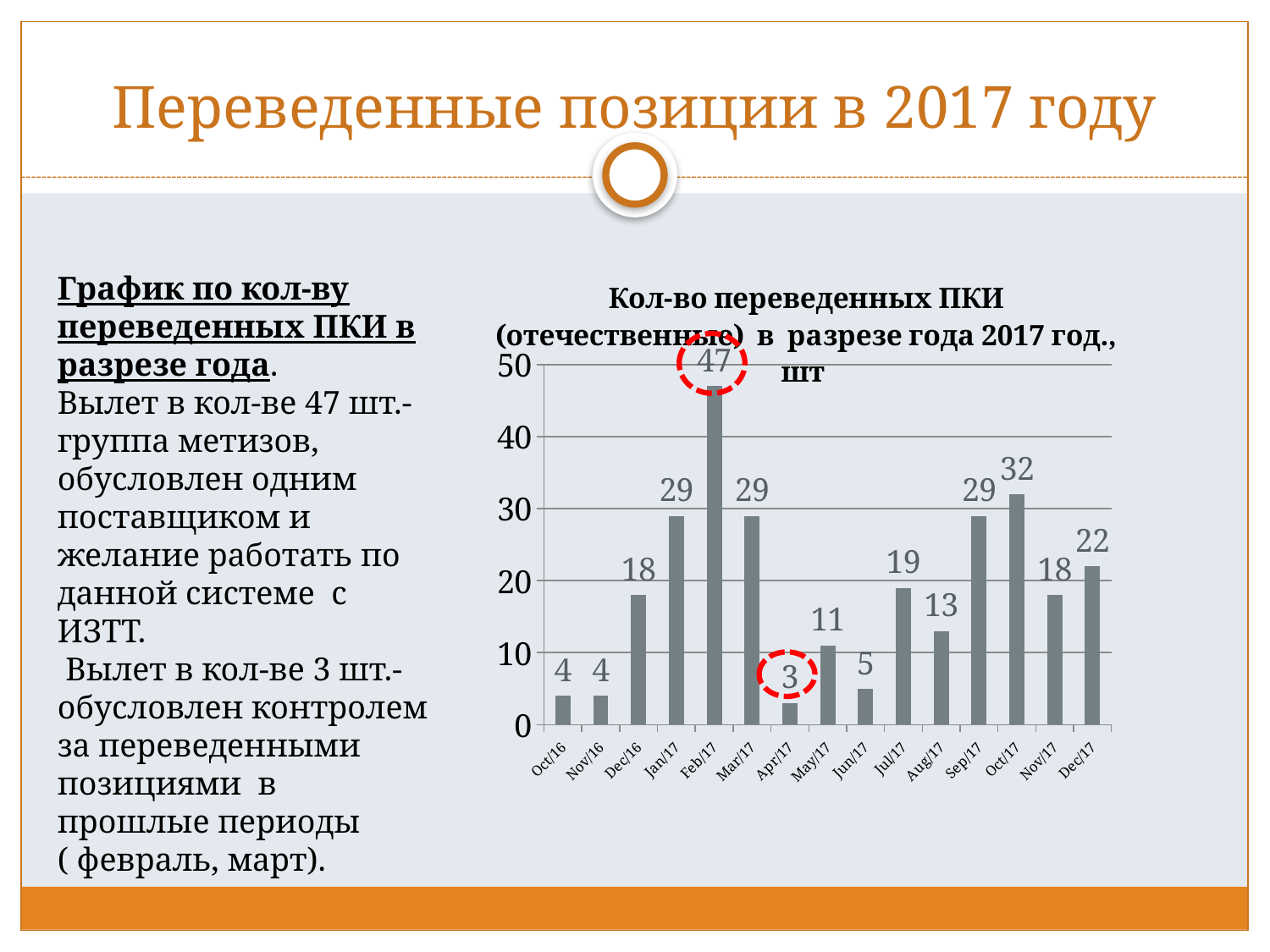
Do the values rise or fall from Apr/17 to Jul/17? Rise How many months are shown on the x axis? 15 Which month has the lowest value? Apr/17 What is the value for Feb/17? 47 What is the value for Oct/17? 32 Which month has the highest value? Feb/17 Which is larger, the value for Jul/17 or the value for Dec/17? Dec/17 What is the value for Apr/17? 3 What kind of chart is shown on the slide? Bar chart What is the difference between the values for Oct/17 and Nov/17? 14 What is the value for Aug/17? 13 What is the difference between the values for Feb/17 and Apr/17? 44